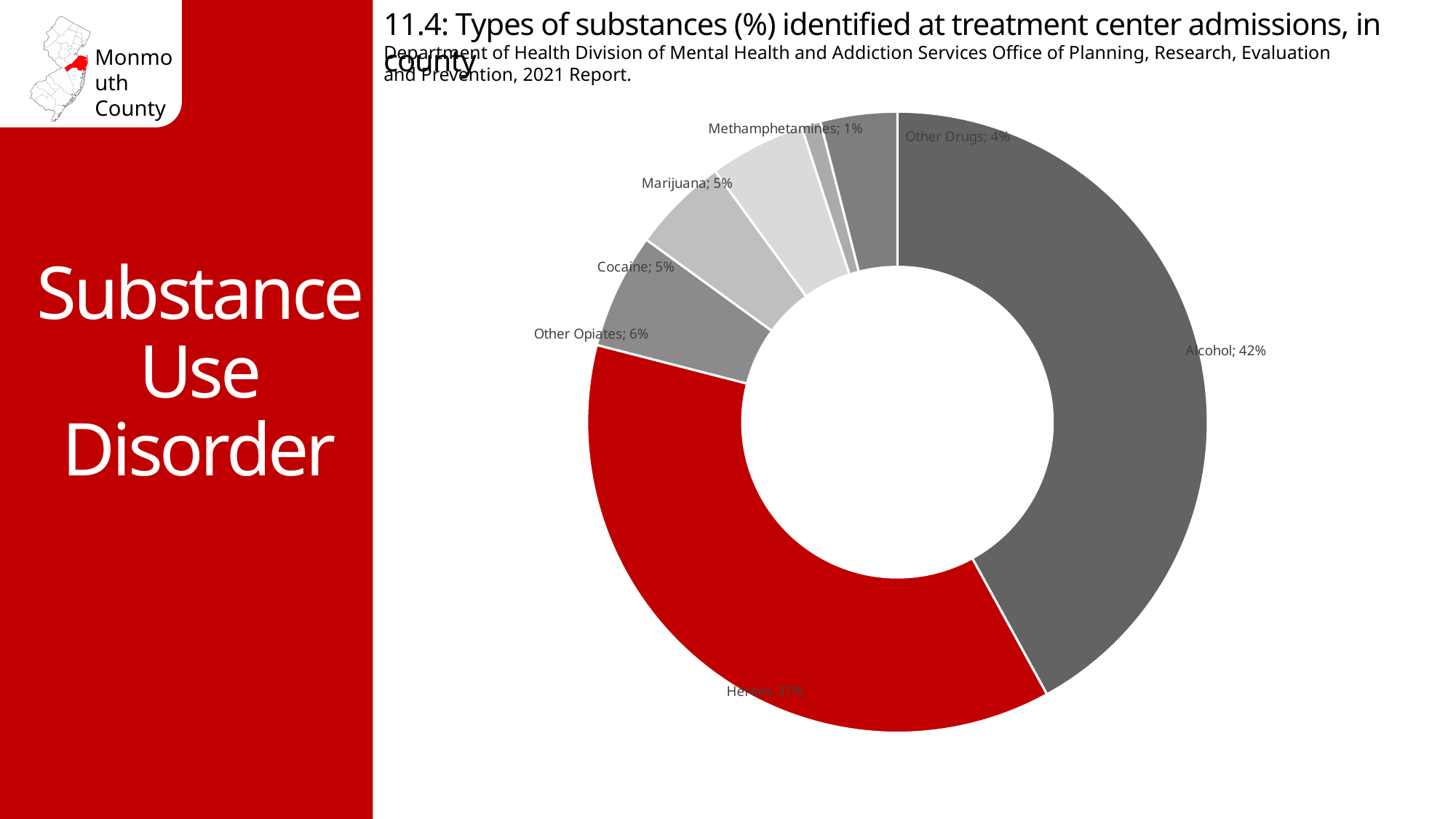
How many substance categories are shown in the chart? 7 Which slice of the chart is coloured red? Heroin What percentage of treatment center admissions identified Alcohol as the substance? 42% Which is larger, the share for Other Opiates or the share for Other Drugs? Other Opiates What percentage is shown for Methamphetamines? 1% Which substance has the largest share of admissions? Alcohol What percentage is shown for Other Drugs? 4% What is the difference in percentage points between Alcohol and Heroin? 5 Which substance has the smallest share of admissions? Methamphetamines What percentage is shown for Other Opiates? 6% What percentage is shown for Heroin? 37% What type of chart is used on this slide? Doughnut (pie) chart